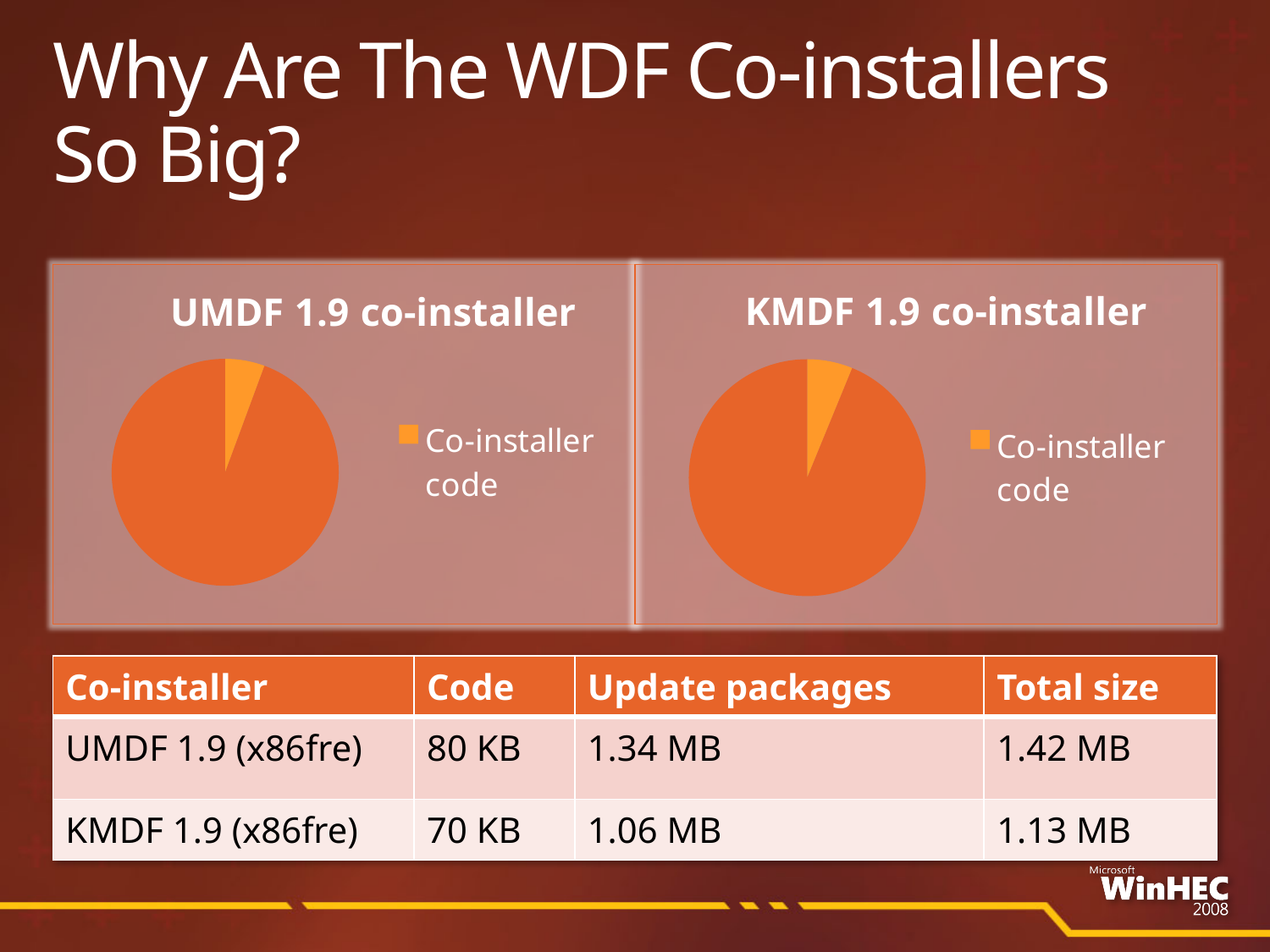
In the UMDF 1.9 co-installer pie chart, is the Co-installer code slice greater or less than 50% of the pie? less In the KMDF 1.9 co-installer pie chart, is the Co-installer code slice larger or smaller than the other slice? smaller What is the legend entry shown next to the KMDF 1.9 co-installer pie chart? Co-installer code In the UMDF 1.9 co-installer pie chart, is the Co-installer code slice larger or smaller than the other slice? smaller What kind of chart is the UMDF 1.9 co-installer chart? pie chart What is the title of the left-hand pie chart? UMDF 1.9 co-installer How many charts are shown on the slide? 2 How many slices does the UMDF 1.9 co-installer pie chart have? 2 What kind of chart is the KMDF 1.9 co-installer chart? pie chart How many slices does the KMDF 1.9 co-installer pie chart have? 2 How many entries does the legend of the KMDF 1.9 co-installer chart list? 1 How many entries does the legend of the UMDF 1.9 co-installer chart list? 1